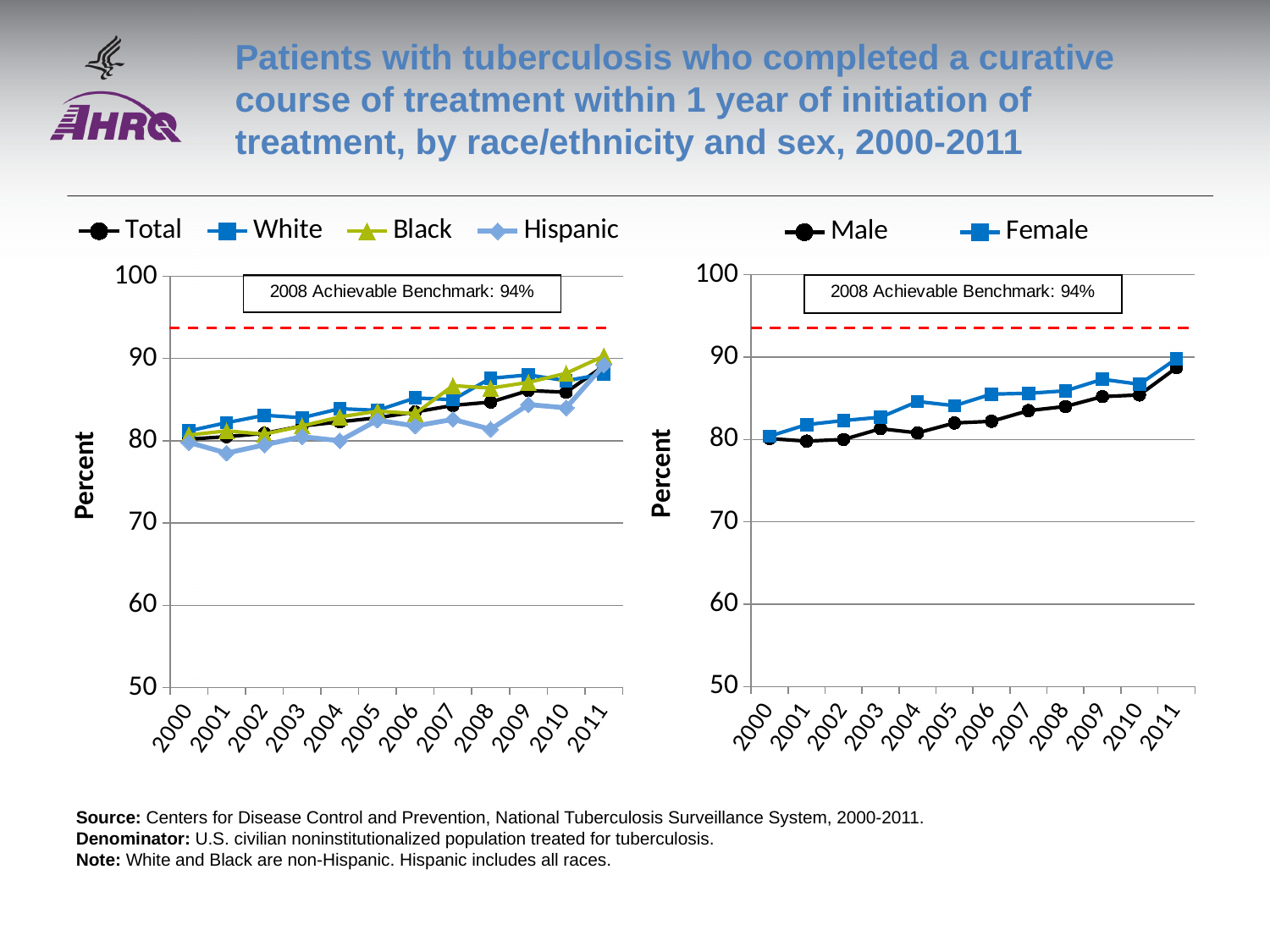
In the left chart, is the value for Hispanic in 2001 greater or less than 80? less What kind of chart is the left chart (by race/ethnicity)? line chart In the right chart, which is larger in 2004, Male or Female? Female How many series does the legend of the right chart (Male/Female) list? 2 In the left chart, what is the 2008 Achievable Benchmark shown? 94% In the left chart, which is larger in 2008, White or Hispanic? White In the right chart, is the value for Male in 2011 greater or less than 90? less How many series does the legend of the left chart list? 4 In the right chart, is the value for Female in 2004 greater or less than 80? greater In the right chart, do the Male values generally rise or fall from 2000 to 2011? rise How many years are plotted along the x axis of the right chart? 12